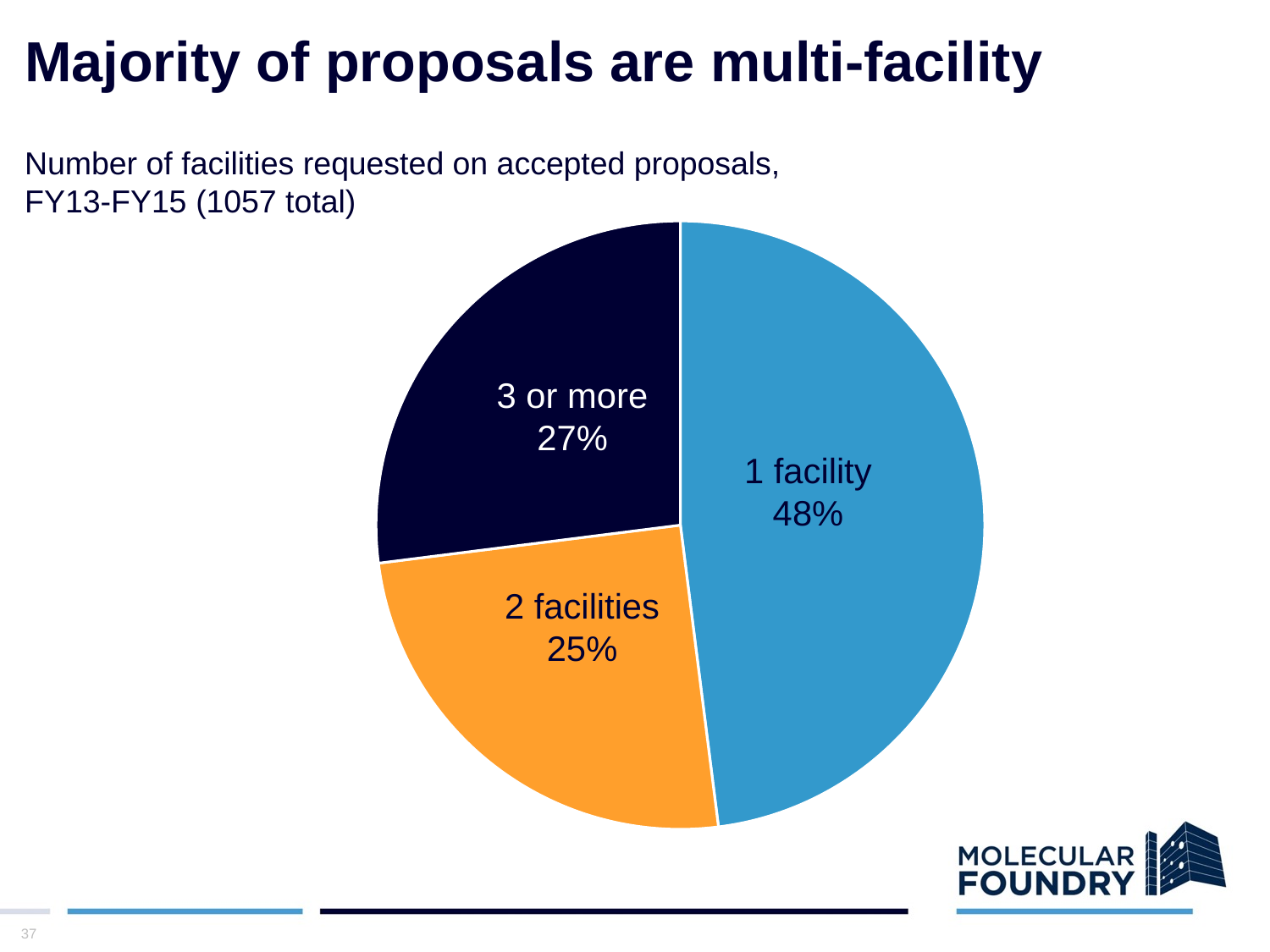
What is the difference in percentage points between the 1 facility slice and the 2 facilities slice? 23 What share of accepted proposals requested 1 facility? 48% What is the combined share of proposals requesting 2 facilities or 3 or more facilities? 52% What colour is the slice for 2 facilities? orange How many slices does the pie chart have? 3 Which is larger, the share for 1 facility or the share for 3 or more facilities? 1 facility Which category has the smallest slice of the pie? 2 facilities What share of accepted proposals requested 2 facilities? 25% What kind of chart is shown on the slide? pie chart Which category has the largest slice of the pie? 1 facility What share of accepted proposals requested 3 or more facilities? 27% What is the difference in percentage points between the 3 or more slice and the 2 facilities slice? 2